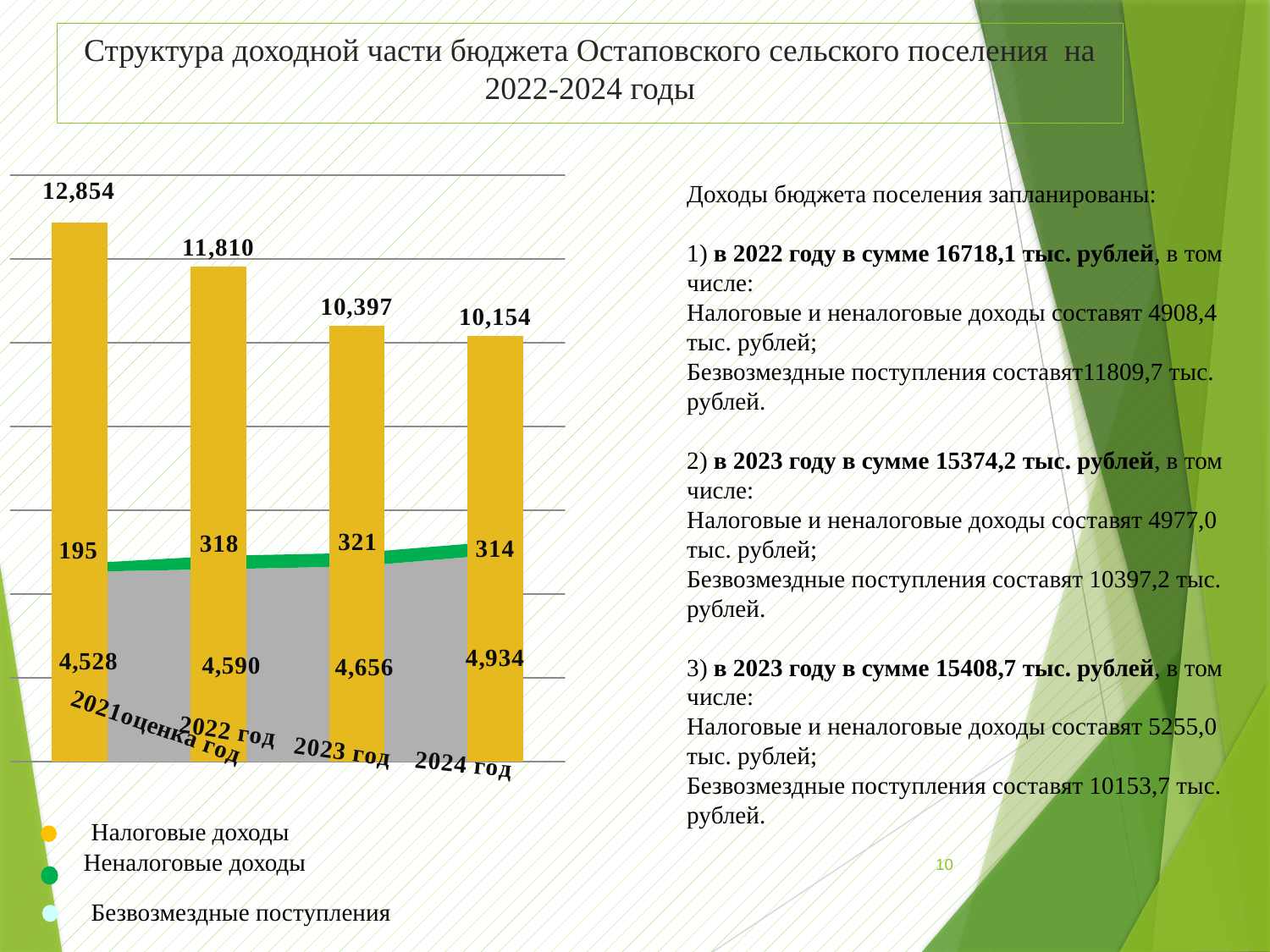
Which is larger: the grey series value for 2023 год or for 2024 год? 2024 год How many series does the legend list? 3 Do the yellow bar values rise or fall from 2021 оценка to 2024 год? fall What is the value printed on the green series for 2023 год? 321 What is the value printed above the yellow bar for 2024 год? 10,154 Which category has the lowest value on the grey series? 2021 оценка How many categories are shown on the x axis of the chart? 4 What is the difference between the yellow bar values for 2021 оценка and 2024 год? 2,700 Which category has the tallest yellow bar? 2021 оценка What is the value printed on the grey series for 2021 оценка? 4,528 What is the value printed above the yellow bar for 2022 год? 11,810 What is the title of the slide containing the chart? Структура доходной части бюджета Остаповского сельского поселения на 2022-2024 годы